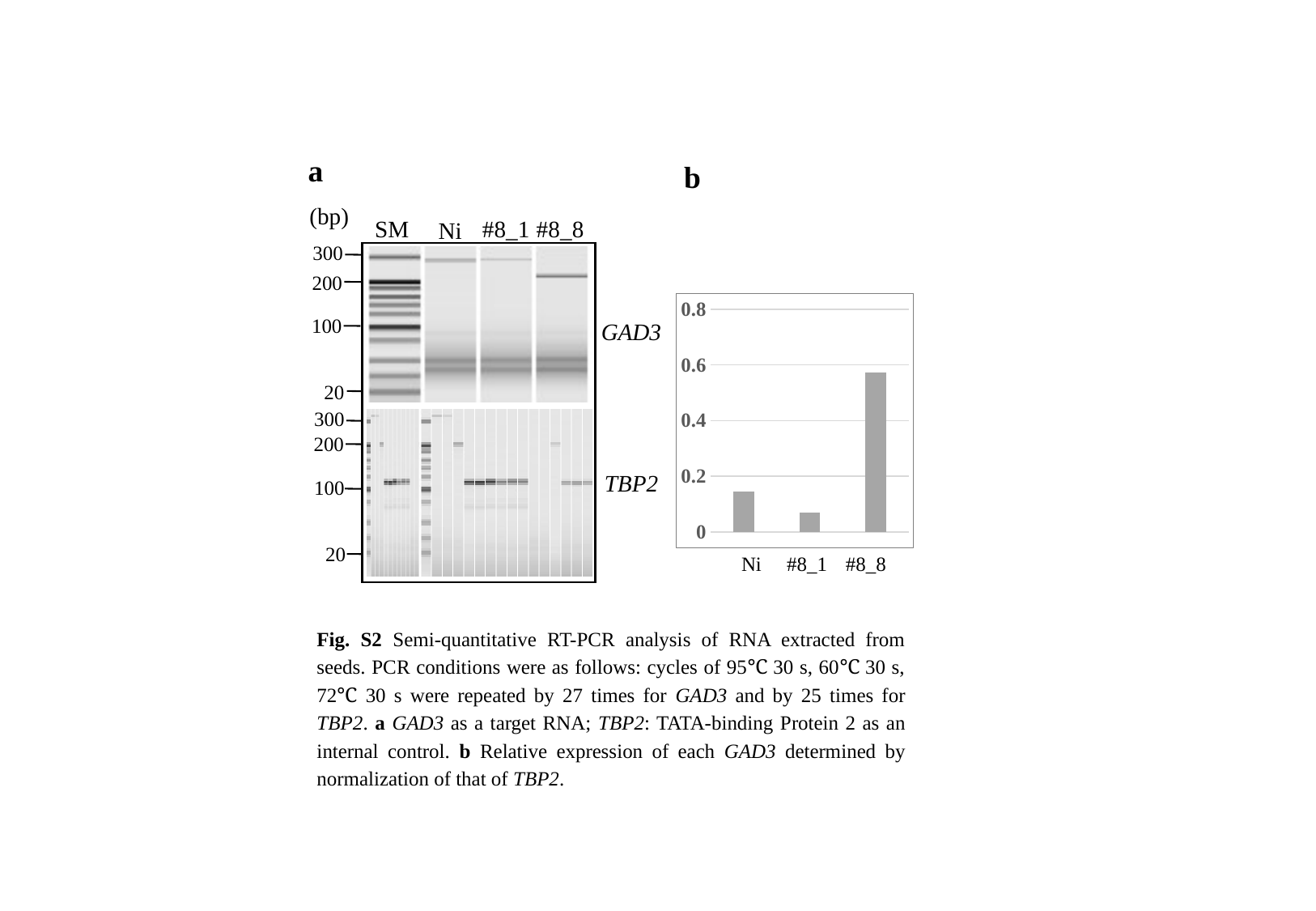
In the bar chart in panel b, is the value for #8_1 greater or less than 0.2? less In the bar chart in panel b, what kind of chart is shown? bar chart In the bar chart in panel b, what are the category labels on the x axis, from left to right? Ni, #8_1, #8_8 In the bar chart in panel b, which is larger, the value for #8_8 or the value for Ni? #8_8 In the bar chart in panel b, which is larger, the value for Ni or the value for #8_1? Ni In the bar chart in panel b, which category has the highest bar? #8_8 In the bar chart in panel b, is the value for #8_8 greater or less than 0.4? greater In the bar chart in panel b, what is the highest value shown on the y axis? 0.8 In the bar chart in panel b, which category has the lowest bar? #8_1 In the bar chart in panel b, is the value for Ni greater or less than 0.2? less In the bar chart in panel b, how many categories are plotted on the x axis? 3